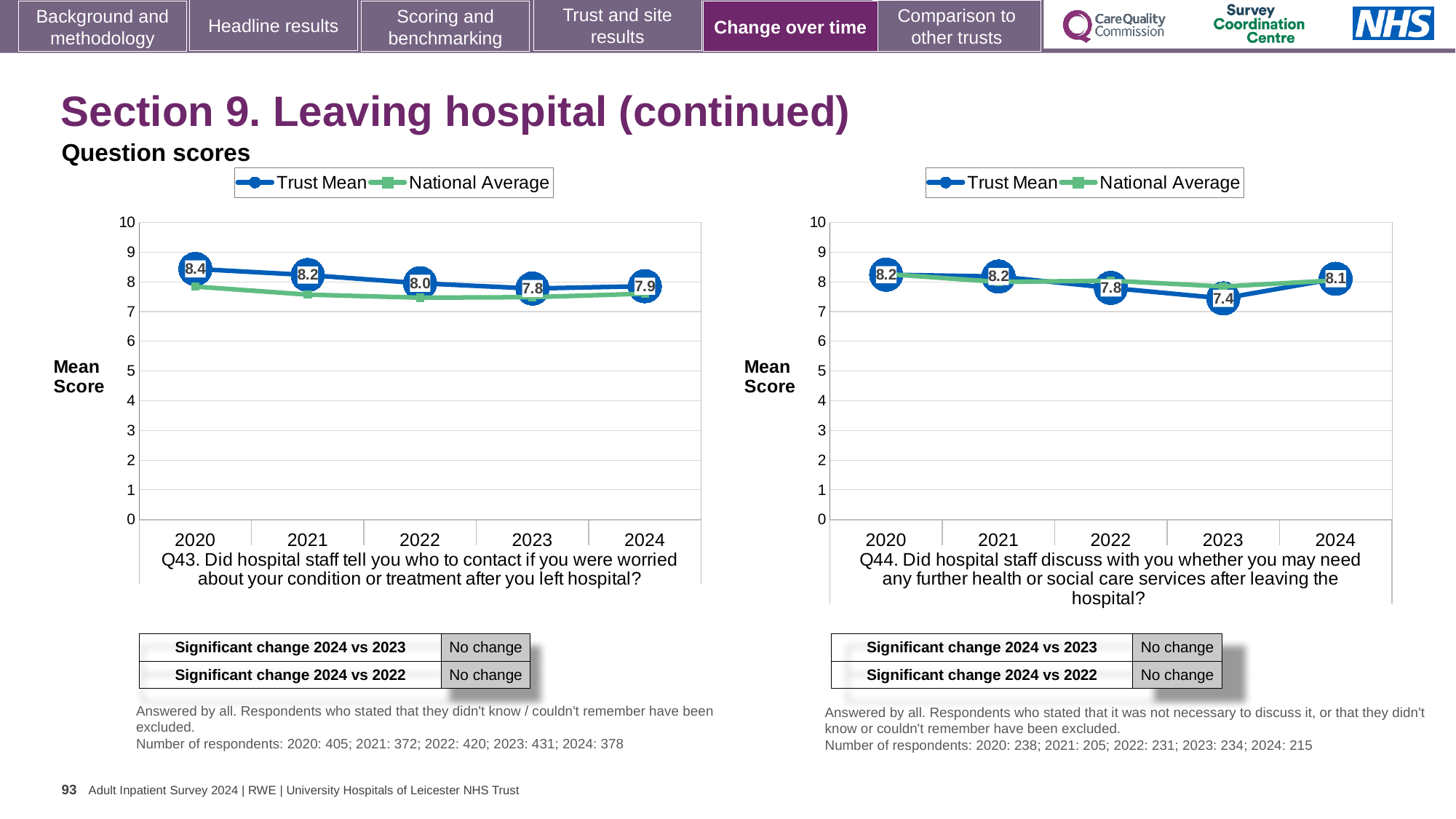
In the Q43 chart on the left, does the Trust Mean rise or fall from 2020 to 2023? Fall In the Q43 chart on the left, is the National Average value for 2020 greater or less than 7? greater In the Q43 chart on the left, what is the Trust Mean score for 2020? 8.4 In the Q43 chart on the left, what is the difference between the Trust Mean scores for 2020 and 2024? 0.5 What kind of chart is the Q43 chart on the left? Line chart In the Q44 chart on the right, what is the difference between the Trust Mean scores for 2021 and 2023? 0.8 In the Q44 chart on the right, which year has the lowest Trust Mean score? 2023 How many years are shown on the x axis of the Q43 chart on the left? 5 In the Q44 chart on the right, which is larger: the Trust Mean for 2022 or for 2024? 2024 In the Q44 chart on the right, what is the Trust Mean score for 2023? 7.4 In the Q43 chart on the left, which year has the highest Trust Mean score? 2020 How many series does the legend of the Q44 chart on the right list? 2